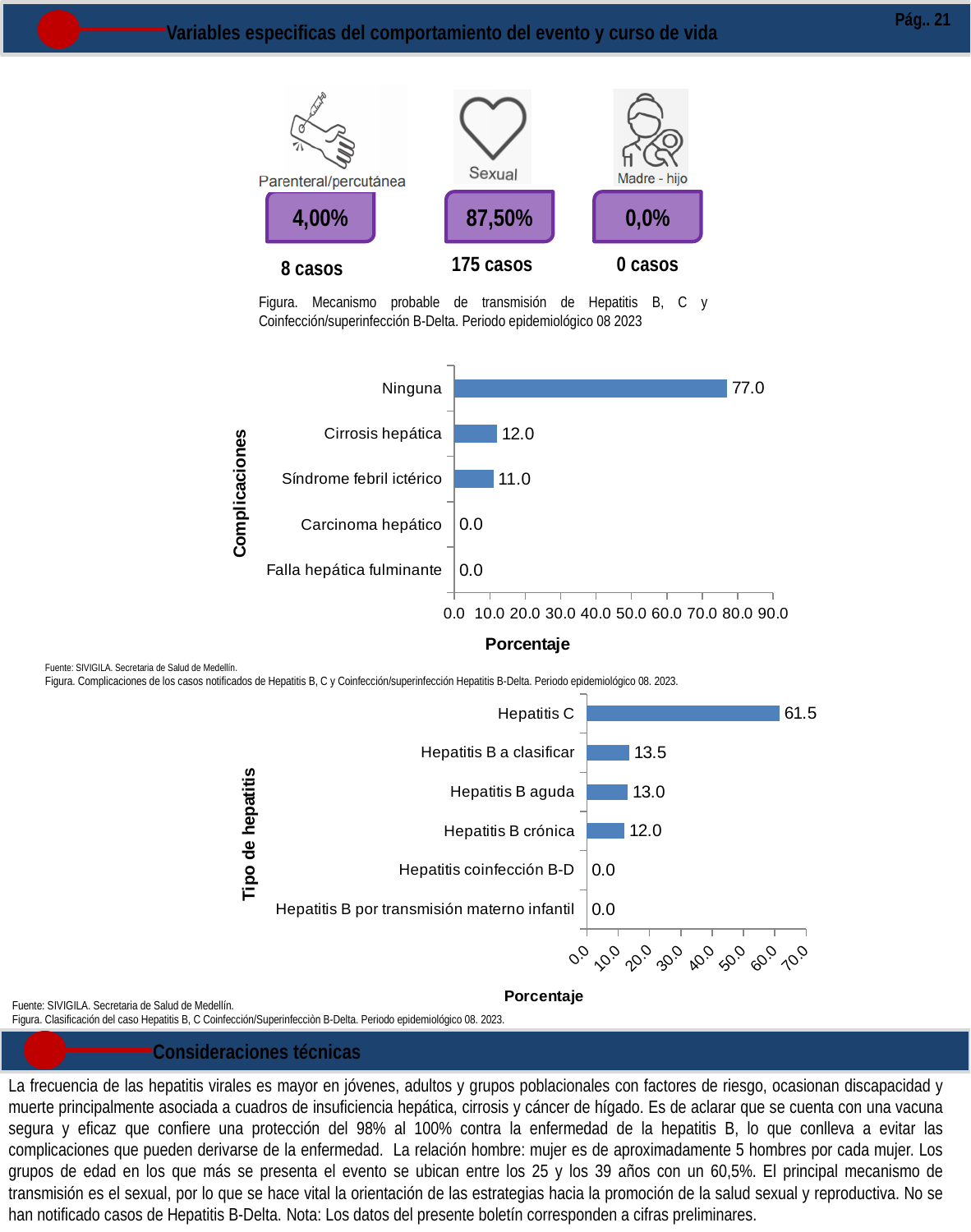
In the lower bar chart (Tipo de hepatitis), which is larger, Hepatitis B a clasificar or Hepatitis B aguda? Hepatitis B a clasificar In the upper bar chart (Complicaciones), what is the value for Ninguna? 77.0 What kind of chart is the lower chart (Tipo de hepatitis)? Bar chart In the lower bar chart (Tipo de hepatitis), what is the value for Hepatitis B crónica? 12.0 In the upper bar chart (Complicaciones), which category has the highest value? Ninguna In the upper bar chart (Complicaciones), what is the value for Síndrome febril ictérico? 11.0 In the lower bar chart (Tipo de hepatitis), how many categories are shown on the y axis? 6 In the upper bar chart (Complicaciones), what is the label of the x axis? Porcentaje In the upper bar chart (Complicaciones), how many categories are shown on the y axis? 5 In the upper bar chart (Complicaciones), what is the difference between Cirrosis hepática and Síndrome febril ictérico? 1.0 In the lower bar chart (Tipo de hepatitis), what is the value for Hepatitis C? 61.5 In the lower bar chart (Tipo de hepatitis), what is the difference between Hepatitis C and Hepatitis B a clasificar? 48.0